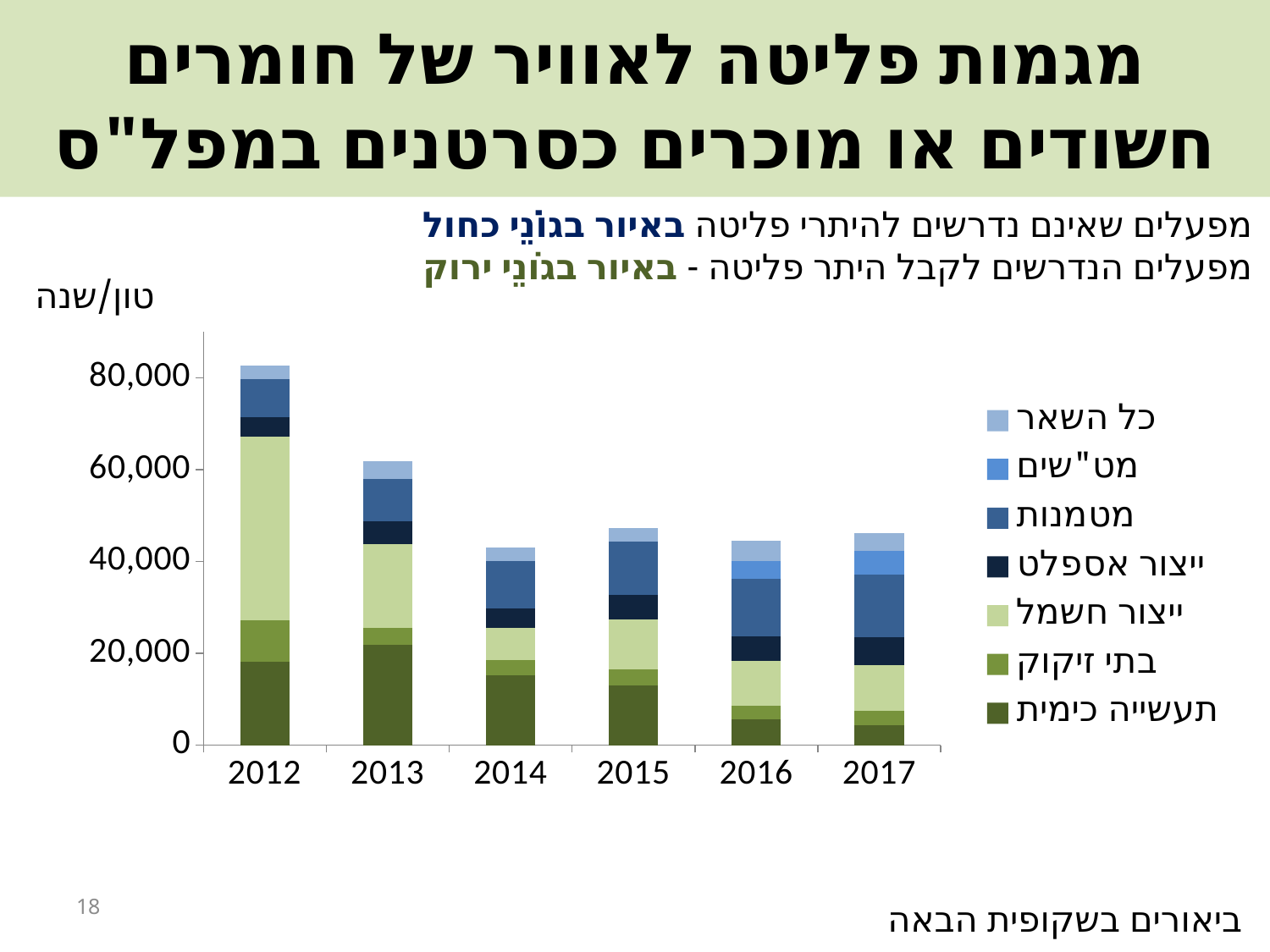
What kind of chart is shown on the slide? Stacked bar chart Is the total for 2015 greater or less than 60,000? less What unit is shown on the y axis of the chart? טון/שנה How many years are shown on the x axis of the chart? 6 Is the total for 2012 greater or less than 60,000? greater How many series does the chart's legend list? 7 Which year has the larger total, 2012 or 2013? 2012 Which series forms the largest segment of the 2012 bar? ייצור חשמל Which year has the highest total emissions in the chart? 2012 Is the total for 2014 greater or less than 40,000? greater Do the total emissions rise or fall from 2012 to 2014? Fall